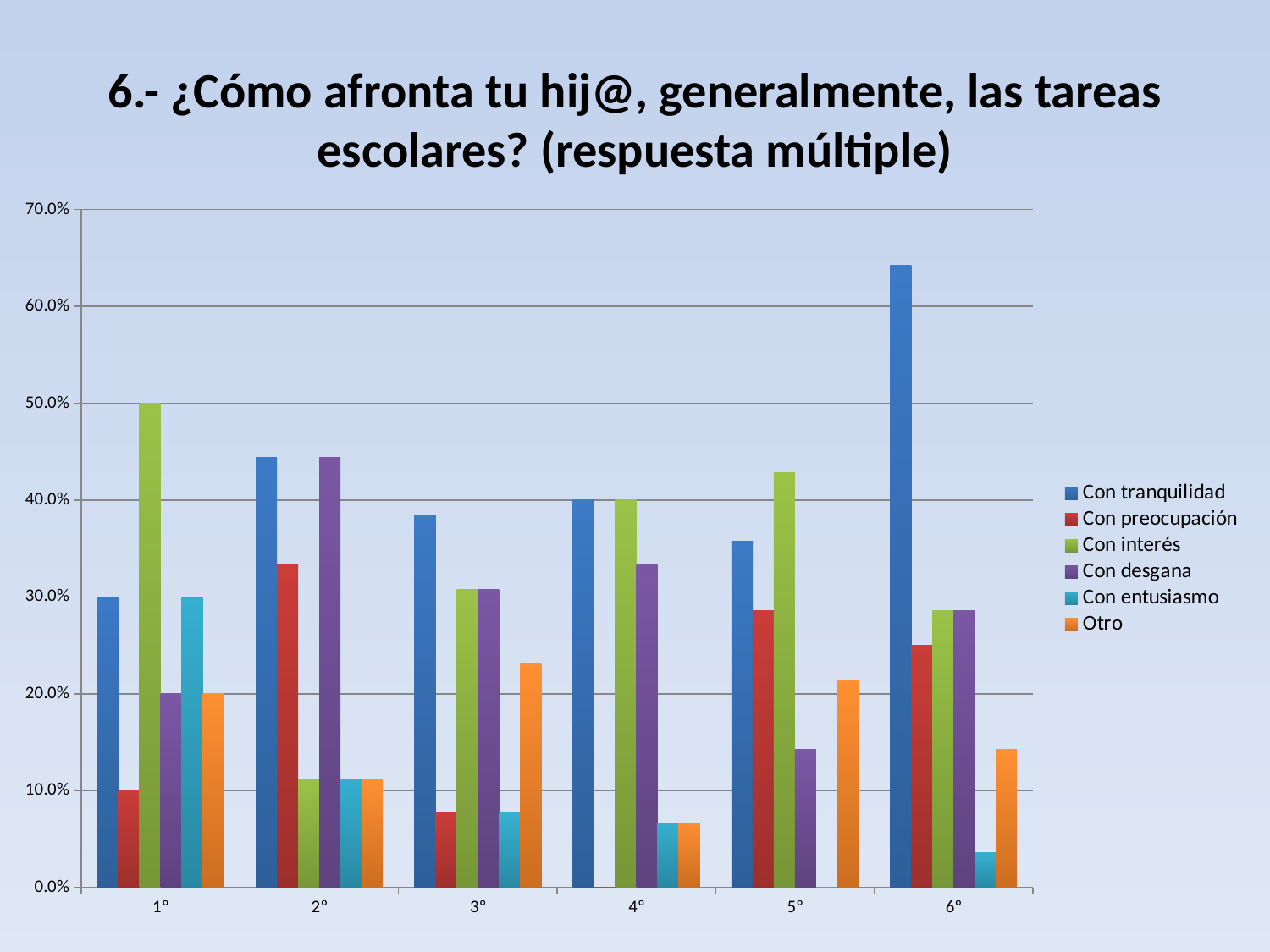
What type of chart is shown on the slide? bar chart Is the value for Otro in category 3° greater or less than 20.0%? greater Is the value for Con tranquilidad in category 6° greater or less than 60.0%? greater What is the value for Con tranquilidad in category 4°? 40.0% How many series does the legend list? 6 How many categories are shown on the x axis? 6 Which category has the highest value for Con tranquilidad? 6° Which category has the lowest value for Con entusiasmo? 5° What is the value for Con interés in category 1°? 50.0% Which series is shown in orange in the legend? Otro What is the value for Con desgana in category 1°? 20.0% In category 5°, which is larger: Con interés or Con desgana? Con interés